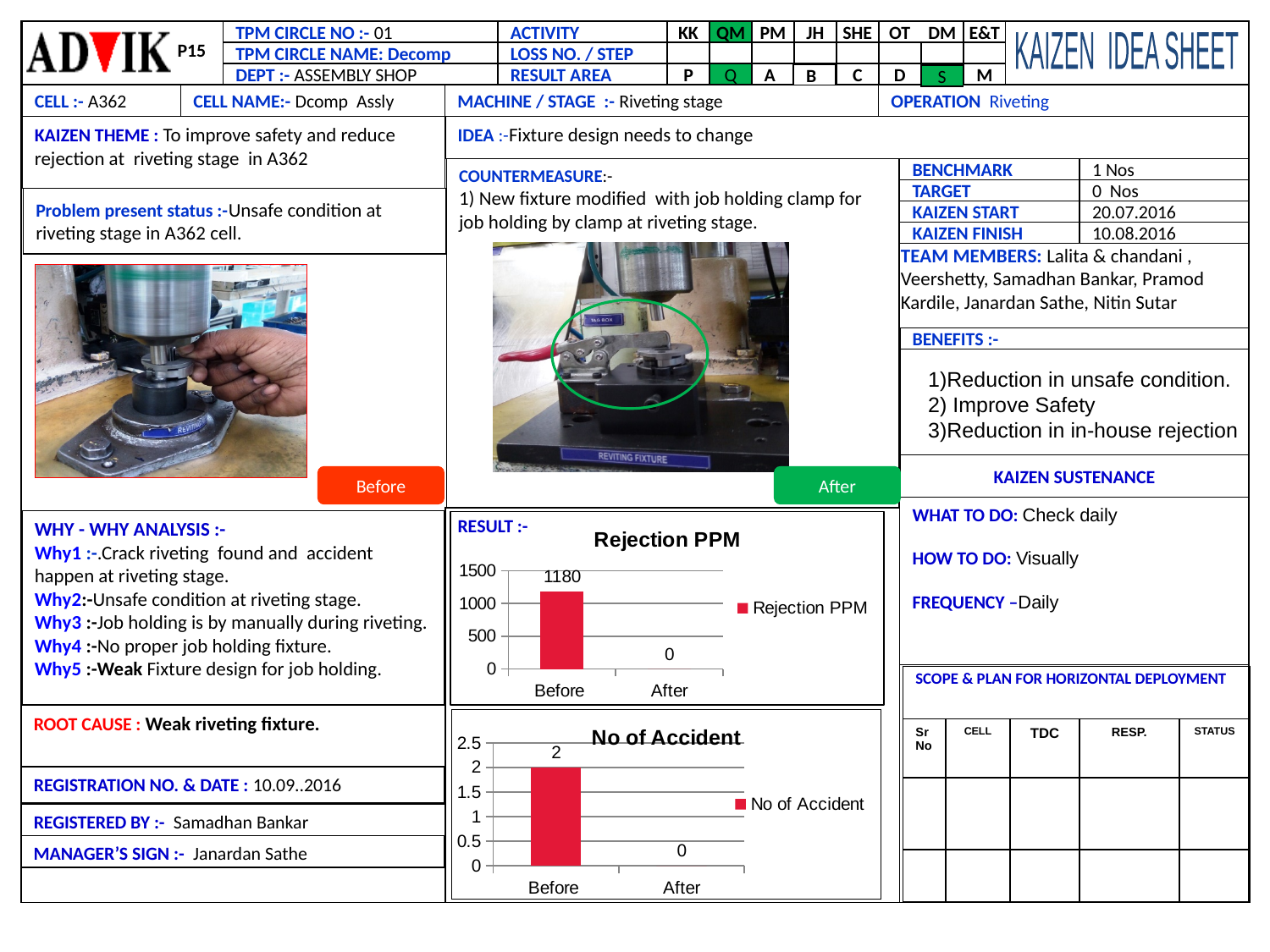
What kind of chart is the No of Accident chart? bar chart In the Rejection PPM chart, which category has the highest value? Before In the Rejection PPM chart, is the value for Before greater or less than 1000? greater In the No of Accident chart, what is the value for After? 0 In the Rejection PPM chart, what is the value for After? 0 In the No of Accident chart, what is the value for Before? 2 In the No of Accident chart, which category has the lowest value? After In the No of Accident chart, how many series does the legend list? 1 In the Rejection PPM chart, what is the value for Before? 1180 In the Rejection PPM chart, what is the difference between the Before and After values? 1180 In the Rejection PPM chart, how many categories are shown on the x axis? 2 In the No of Accident chart, what is the difference between the Before and After values? 2